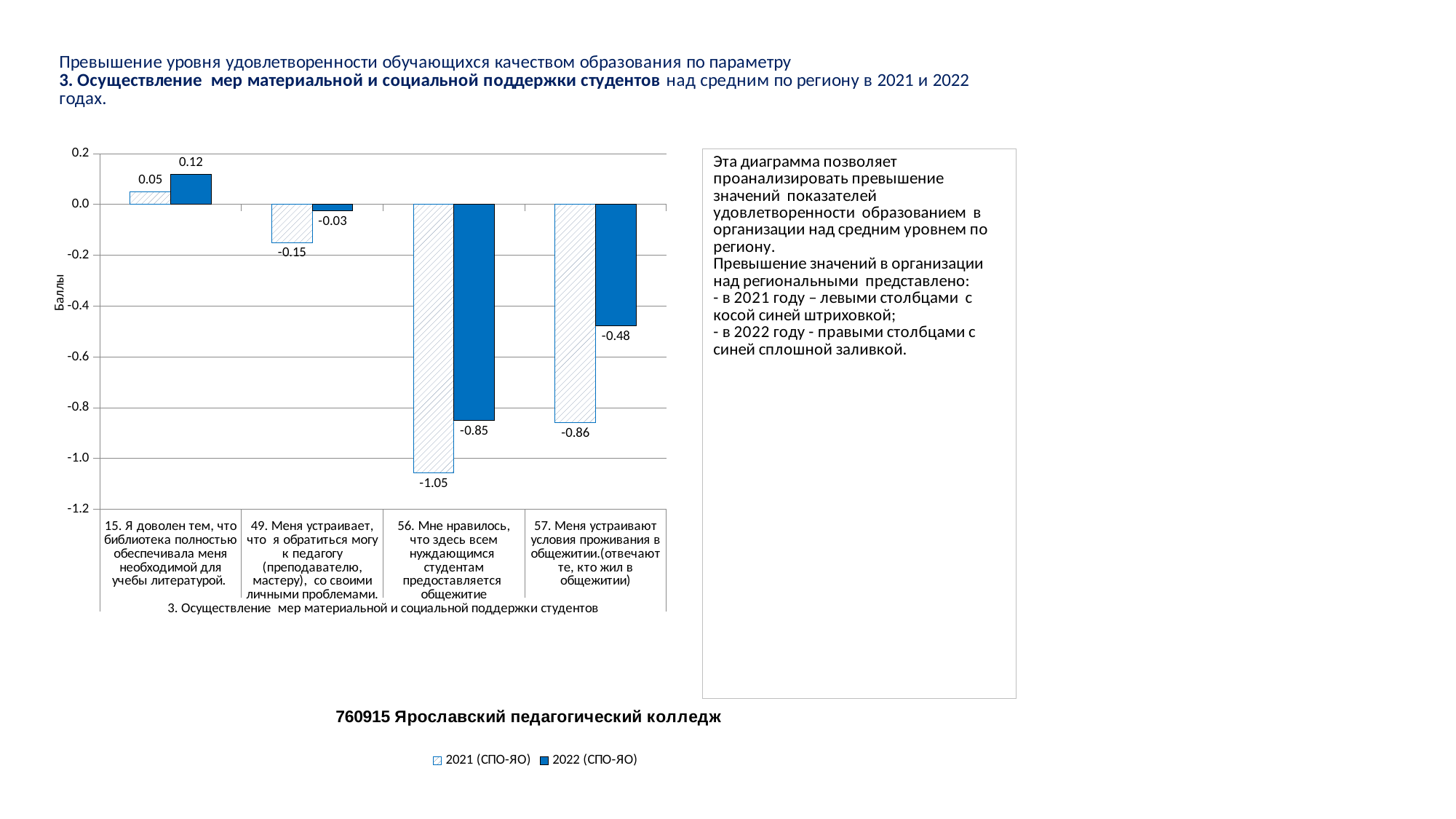
How many series does the chart legend list? 2 What is the value for 2021 (СПО-ЯО) for category 57 (living conditions in the dormitory)? -0.86 For category 56, which series has the larger value, 2021 (СПО-ЯО) or 2022 (СПО-ЯО)? 2022 (СПО-ЯО) What is the value for 2022 (СПО-ЯО) for category 56 (dormitory provided to all students in need)? -0.85 What is the value for 2021 (СПО-ЯО) for category 15 (library provided necessary literature)? 0.05 Which category has the highest value for the 2022 (СПО-ЯО) series? 15. Я доволен тем, что библиотека полностью обеспечивала меня необходимой для учебы литературой. What is the difference between the 2022 and 2021 values for category 57 (living conditions in the dormitory)? 0.38 What is the label of the vertical axis of the chart? Баллы What type of chart is shown on the slide? Bar chart What is the value for 2022 (СПО-ЯО) for category 49 (can approach a teacher with personal problems)? -0.03 How many categories are shown on the x axis of the chart? 4 Which category has the lowest value for the 2021 (СПО-ЯО) series? 56. Мне нравилось, что здесь всем нуждающимся студентам предоставляется общежитие